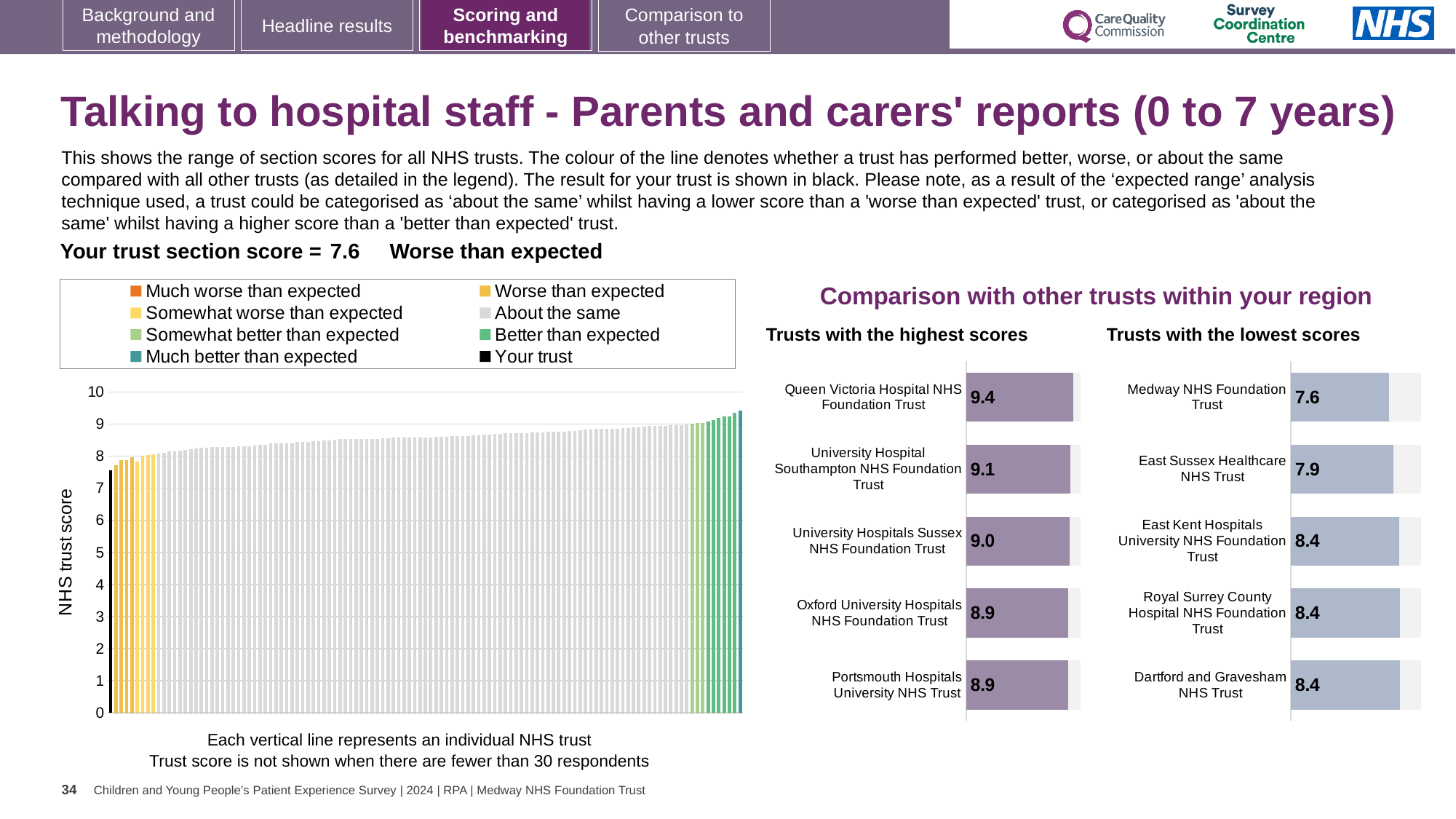
In the 'Trusts with the highest scores' chart, what is the difference between the scores of Queen Victoria Hospital NHS Foundation Trust and University Hospitals Sussex NHS Foundation Trust? 0.4 In the 'Trusts with the highest scores' chart, what is the score for Queen Victoria Hospital NHS Foundation Trust? 9.4 In the main chart on the left showing the range of section scores, what is the score for your trust (shown in black)? 7.6 In the 'Trusts with the highest scores' chart, which trust has the highest score? Queen Victoria Hospital NHS Foundation Trust How many trusts are shown in the 'Trusts with the lowest scores' chart? 5 In the 'Trusts with the lowest scores' chart, what is the score for East Sussex Healthcare NHS Trust? 7.9 How many entries does the legend of the main chart on the left list? 8 In the 'Trusts with the lowest scores' chart, which trust has the lowest score? Medway NHS Foundation Trust In the 'Trusts with the lowest scores' chart, what is the difference between the scores of East Kent Hospitals University NHS Foundation Trust and Medway NHS Foundation Trust? 0.8 What type of chart is the 'Trusts with the highest scores' chart? Bar chart In the 'Trusts with the highest scores' chart, which has a higher score: University Hospital Southampton NHS Foundation Trust or Oxford University Hospitals NHS Foundation Trust? University Hospital Southampton NHS Foundation Trust In the main chart on the left, do the trust scores rise or fall from left to right along the x axis? Rise